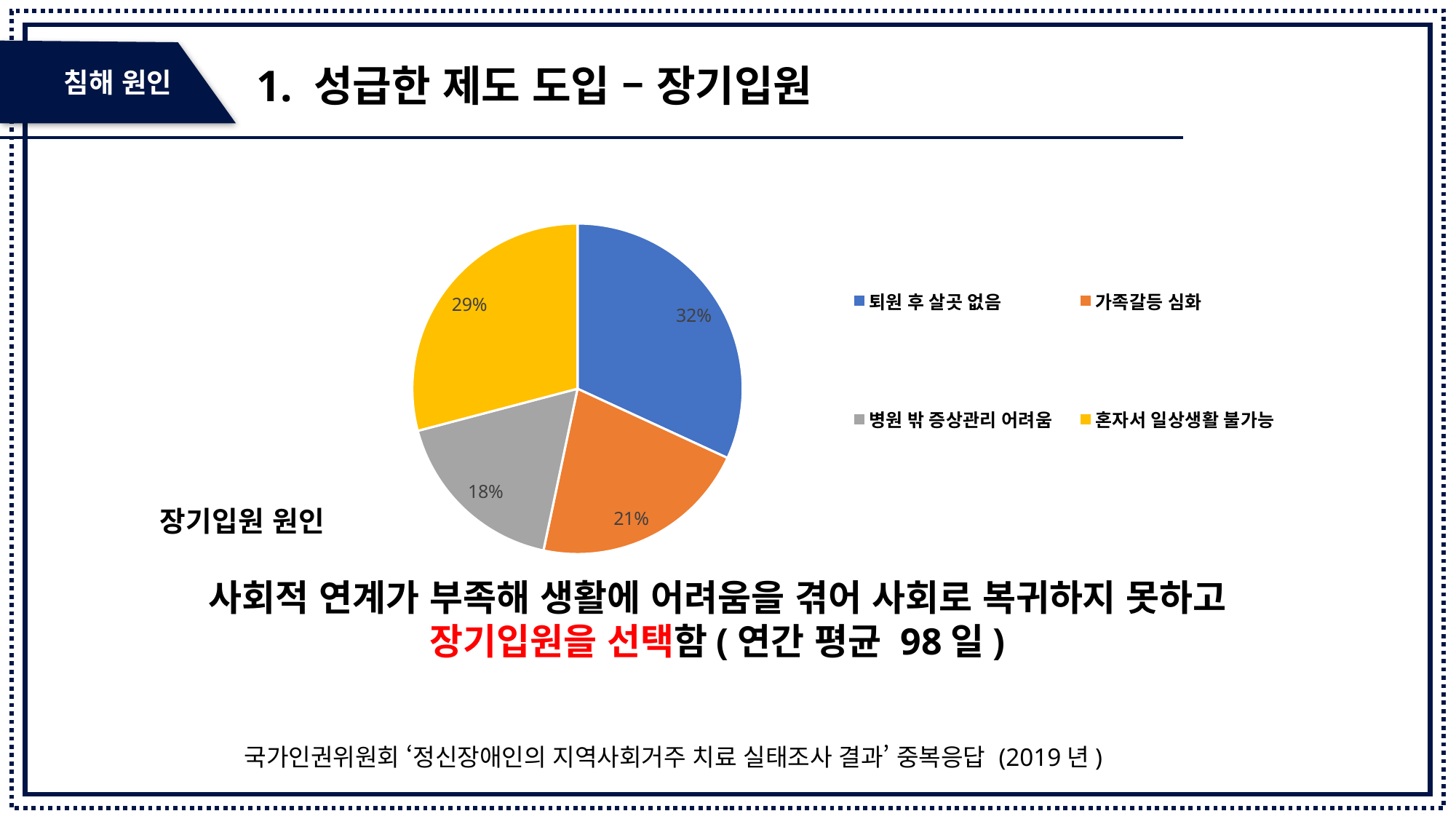
What is the difference in percentage points between 퇴원 후 살곳 없음 and 병원 밖 증상관리 어려움? 14 What is the label shown next to the pie chart describing what it depicts? 장기입원 원인 Which category has the smallest slice of the pie? 병원 밖 증상관리 어려움 What colour is the slice for 혼자서 일상생활 불가능? Yellow What share of the pie does 병원 밖 증상관리 어려움 represent? 18% Which is larger, the slice for 혼자서 일상생활 불가능 or the slice for 가족갈등 심화? 혼자서 일상생활 불가능 What kind of chart is shown on the slide? Pie chart What share of the pie does 퇴원 후 살곳 없음 represent? 32% What share of the pie does 혼자서 일상생활 불가능 represent? 29% Which category has the largest slice of the pie? 퇴원 후 살곳 없음 How many categories are shown in the pie chart? 4 What share of the pie does 가족갈등 심화 represent? 21%